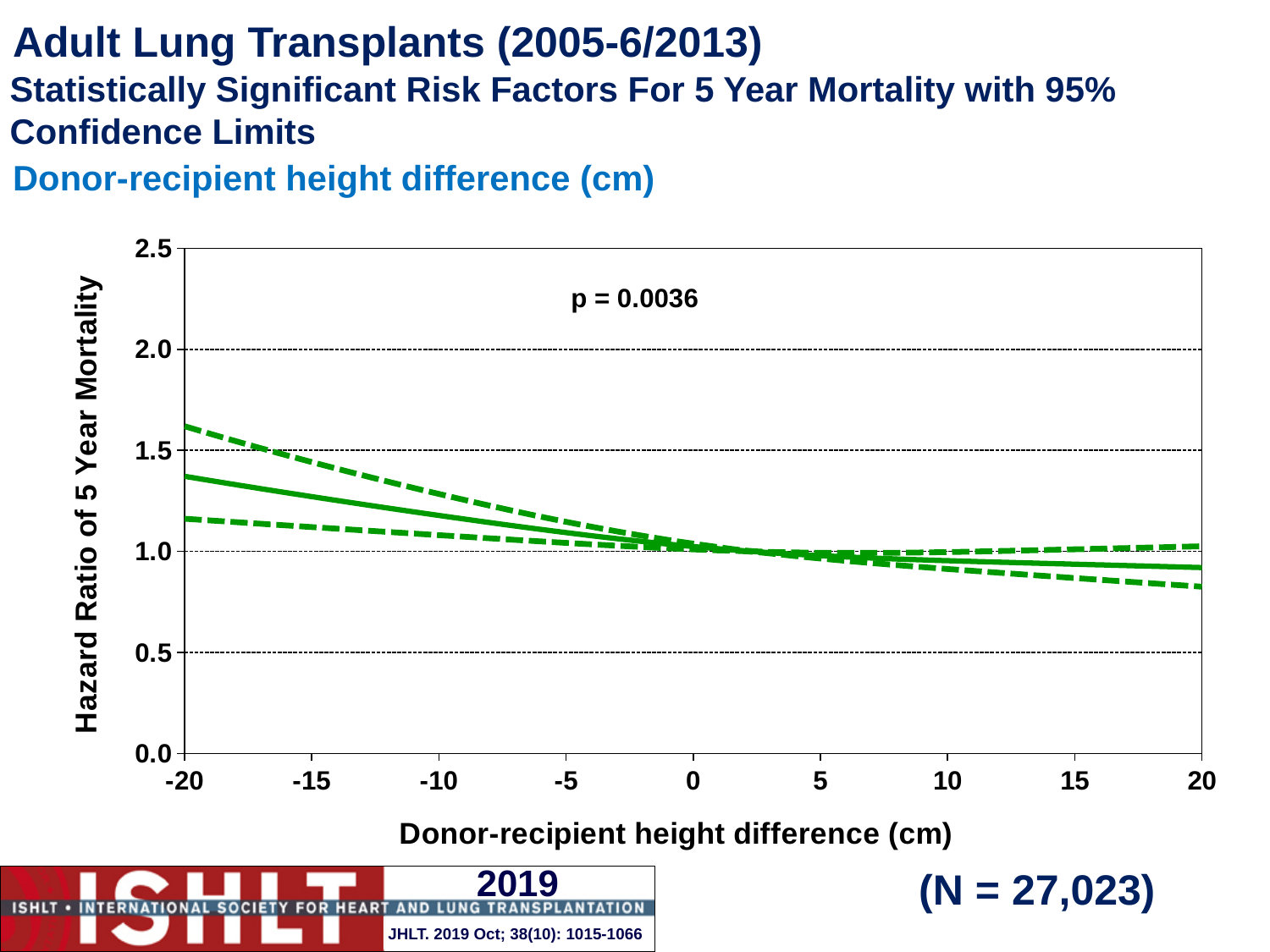
Does the solid hazard ratio line rise or fall as the donor-recipient height difference increases from -20 to 20 cm? Fall How many lines are plotted on the chart? 3 Which has the larger hazard ratio on the solid line: a height difference of -20 cm or 20 cm? -20 cm What p-value is printed on the chart? p = 0.0036 Is the hazard ratio (solid line) at a donor-recipient height difference of 20 cm greater or less than 1.0? less What is the title of the y axis? Hazard Ratio of 5 Year Mortality Is the hazard ratio (solid line) at a donor-recipient height difference of -20 cm greater or less than 1.0? greater Is the upper confidence limit (upper dashed line) at a height difference of -20 cm greater or less than 1.5? greater How many tick labels are shown on the x axis? 9 What kind of chart is shown on the slide? Line chart